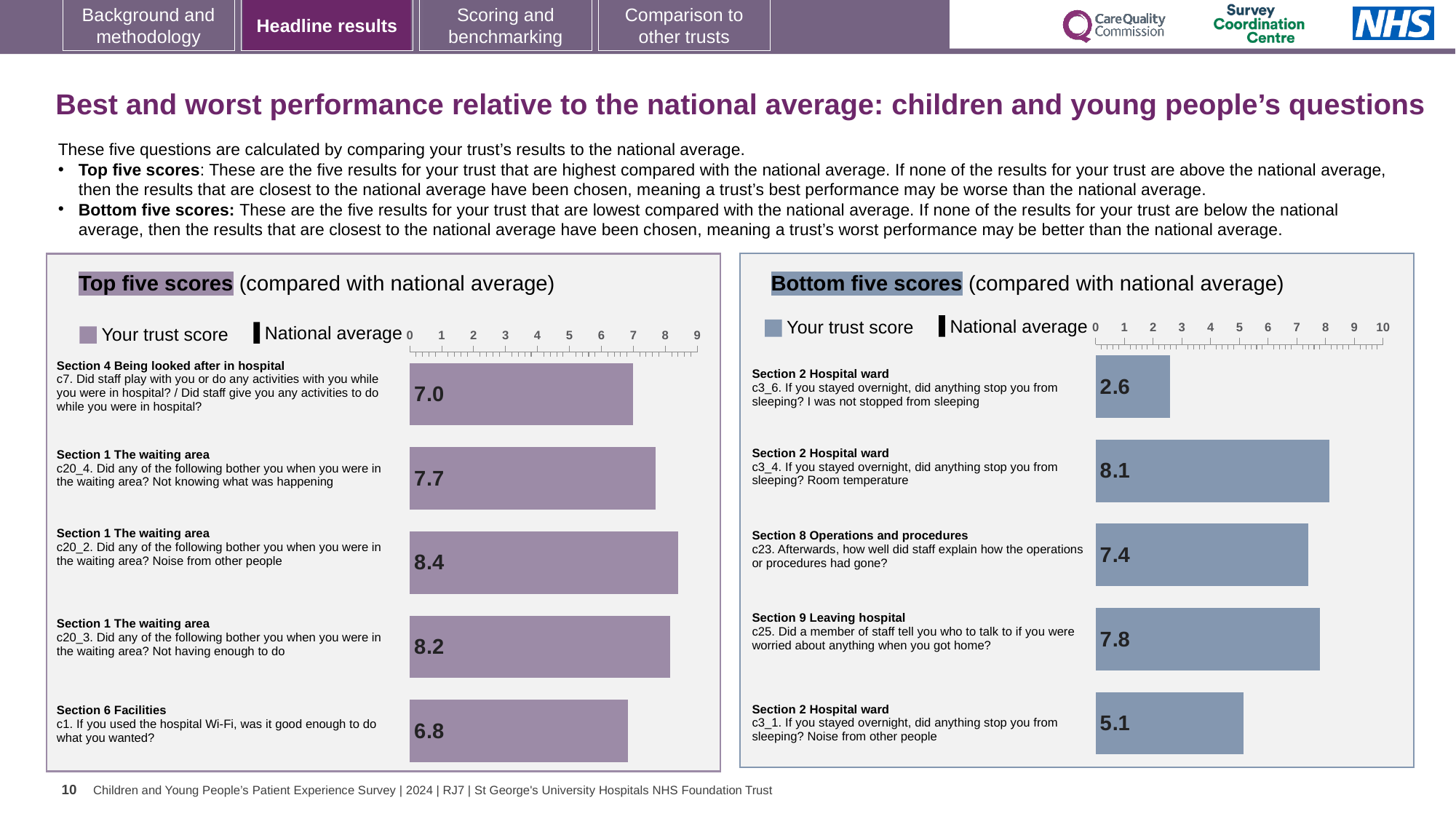
In the Top five scores chart, what is the trust score for c7 (Did staff play with you or do any activities with you while you were in hospital)? 7.0 In the Bottom five scores chart, which question has the lowest trust score? c3_6. I was not stopped from sleeping (2.6) In the Top five scores chart, what is the difference between the scores for c20_2 (8.4) and c1 (6.8)? 1.6 In the Bottom five scores chart, what is the difference between the scores for c3_4 (8.1) and c3_6 (2.6)? 5.5 In the Top five scores chart, what is the trust score for c20_2 (Noise from other people in the waiting area)? 8.4 In the Bottom five scores chart, what is the trust score for c3_6 (I was not stopped from sleeping)? 2.6 How many bars are plotted in the Top five scores chart? 5 In the Top five scores chart, which question has the lowest trust score? c1. Hospital Wi-Fi (6.8) In the Bottom five scores chart, which question has the highest trust score? c3_4. Room temperature (8.1) What kind of chart is the Bottom five scores chart? Bar chart In the Bottom five scores chart, which has the larger trust score: c23 (how well staff explained how operations had gone) or c25 (told who to talk to if worried when home)? c25 (7.8) In the Top five scores chart, which question has the highest trust score? c20_2. Noise from other people (8.4)